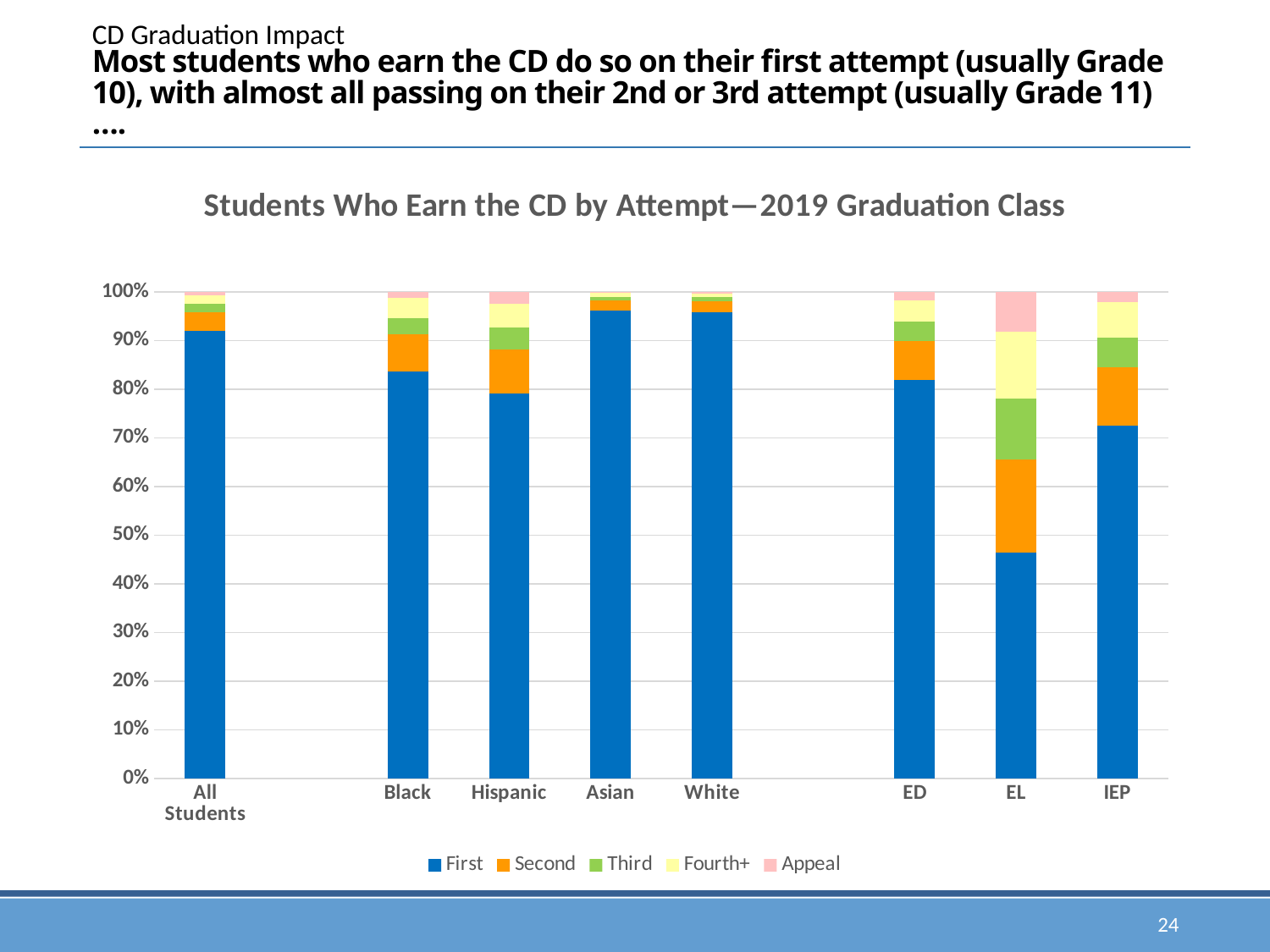
Is the First-attempt share for EL greater or less than 50%? less How many student groups (categories) are shown on the x axis? 8 Is the First-attempt share for IEP students greater or less than 70%? greater What kind of chart is shown on the slide? Stacked bar chart Which group has the largest Second-attempt segment? EL Which group has a larger First-attempt share, EL or IEP? IEP Which group has a larger First-attempt share, Black or Hispanic? Black How many series does the legend list? 5 Which group has the lowest share of students earning the CD on the First attempt? EL What is the title of the chart? Students Who Earn the CD by Attempt—2019 Graduation Class Is the First-attempt share for All Students greater or less than 90%? greater